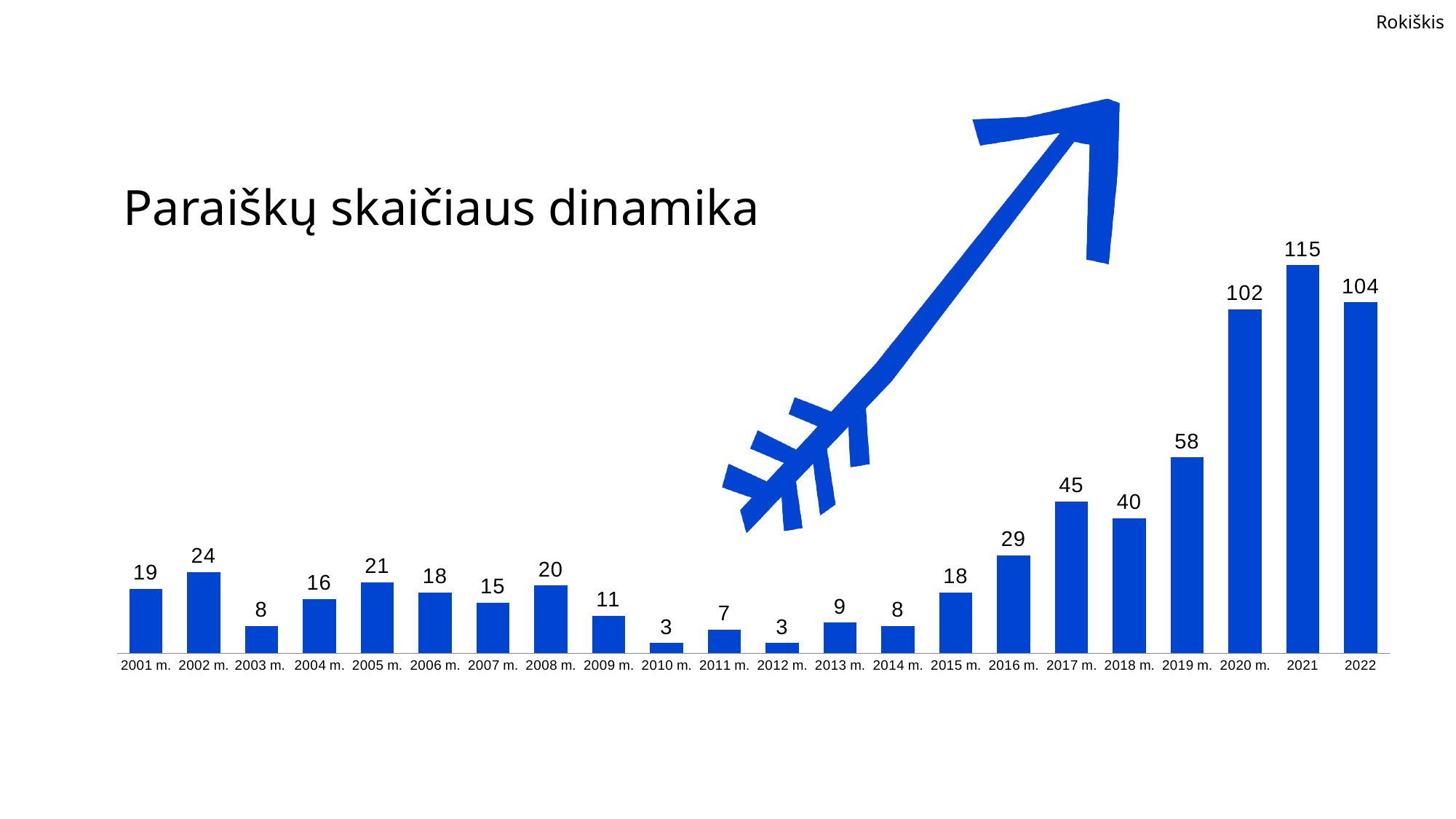
What is the value for 2010 m.? 3 Which is larger, the value for 2018 m. or the value for 2019 m.? 2019 m. What is the difference between the values for 2021 and 2022? 11 Which year has the highest value? 2021 What is the value for 2017 m.? 45 What kind of chart is shown on the slide? Bar chart What is the difference between the values for 2020 m. and 2019 m.? 44 What is the title of the slide containing the chart? Paraiškų skaičiaus dinamika How many years are shown on the x axis? 22 Which is larger, the value for 2002 m. or the value for 2003 m.? 2002 m. Do the values generally rise or fall from 2015 m. to 2021? Rise What is the value for 2021? 115